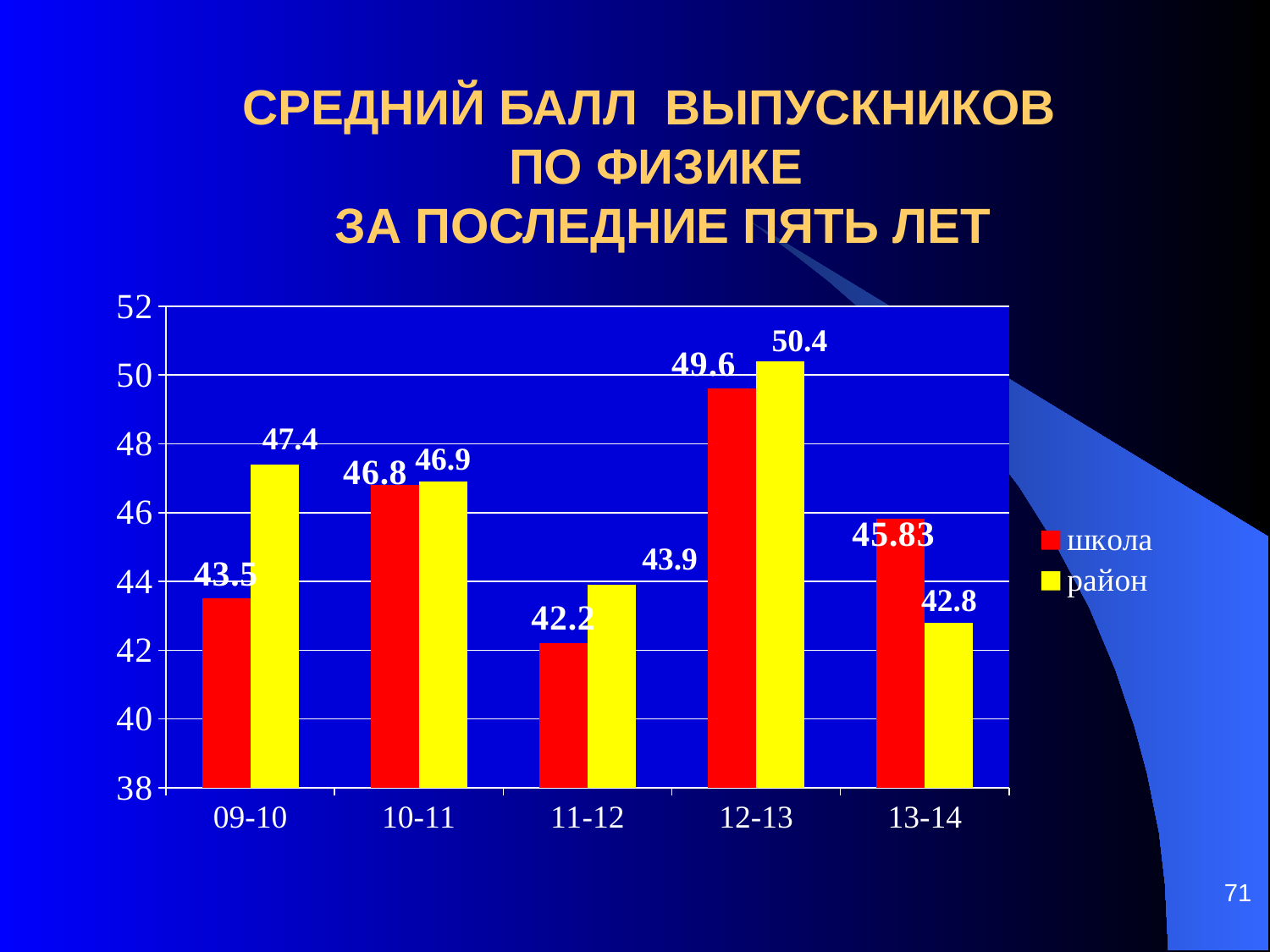
What is the value for район in 11-12? 43.9 What is the value for район in 09-10? 47.4 What is the difference between район and школа in 09-10? 3.9 How many years are shown on the x axis? 5 Which is larger in 13-14, школа or район? школа How many series does the legend list? 2 In which year is the школа value the highest? 12-13 In which year is the район value the lowest? 13-14 What is the value for школа in 13-14? 45.83 What kind of chart is shown on the slide? bar chart In which year is the школа value the lowest? 11-12 What is the value for школа in 12-13? 49.6